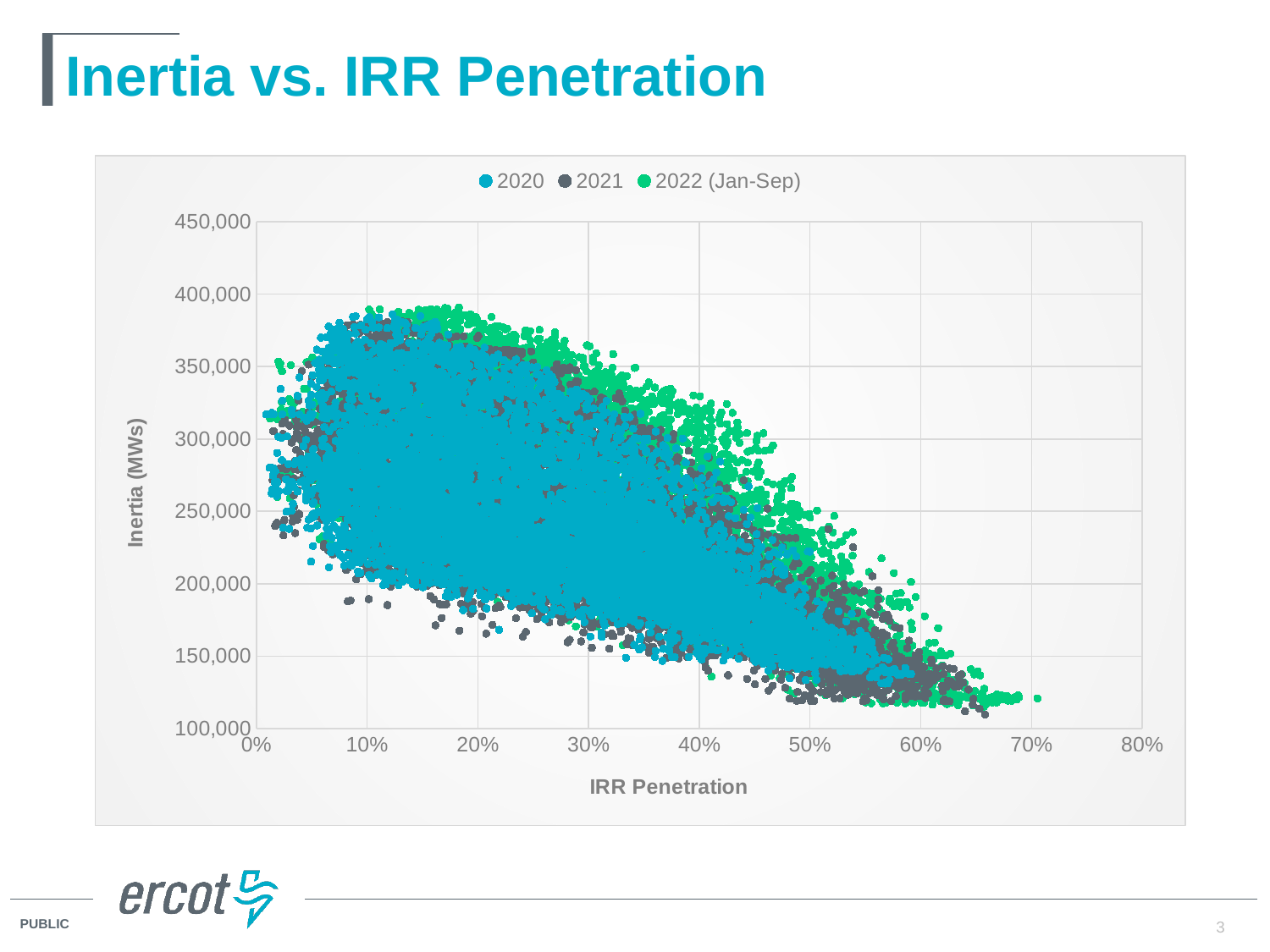
What kind of chart is shown on the slide? Scatter plot Which series extends to the highest IRR penetration values? 2022 (Jan-Sep) What is the highest value shown on the y axis? 450,000 What are the three series listed in the legend? 2020, 2021, 2022 (Jan-Sep) Is the highest inertia value plotted greater or less than 400,000? less Is the lowest inertia value plotted greater or less than 150,000? less What is the label of the y axis? Inertia (MWs) What is the highest value shown on the x axis? 80% Is the highest IRR penetration reached by any point greater or less than 80%? less As IRR Penetration increases along the x axis, does Inertia generally rise or fall? Fall How many series does the legend list? 3